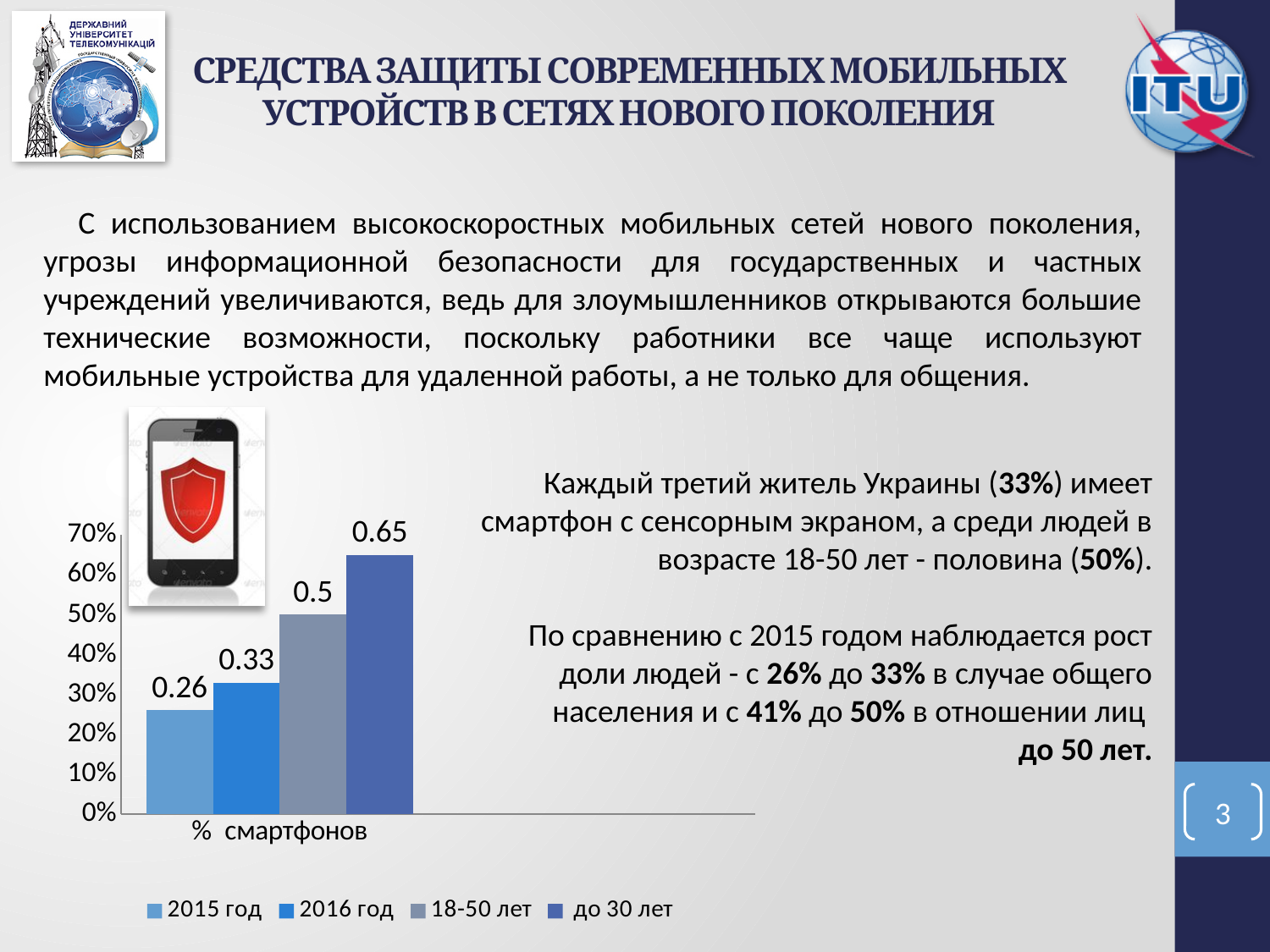
What is the difference between the data labels for 2016 год and 2015 год? 0.07 What is the data label for the до 30 лет series in the chart? 0.65 What is the data label for the 18-50 лет series in the chart? 0.5 Which is larger, the value for 18-50 лет or the value for 2016 год? 18-50 лет What is the data label for the 2016 год series in the chart? 0.33 Which series has the lowest value in the chart? 2015 год Which series has the highest value in the chart? до 30 лет What kind of chart is shown on the slide? bar chart What is the category label shown on the x axis of the chart? % смартфонов How many series does the legend list? 4 Is the bar for до 30 лет greater or less than 60%? greater What is the data label for the 2015 год series in the chart? 0.26